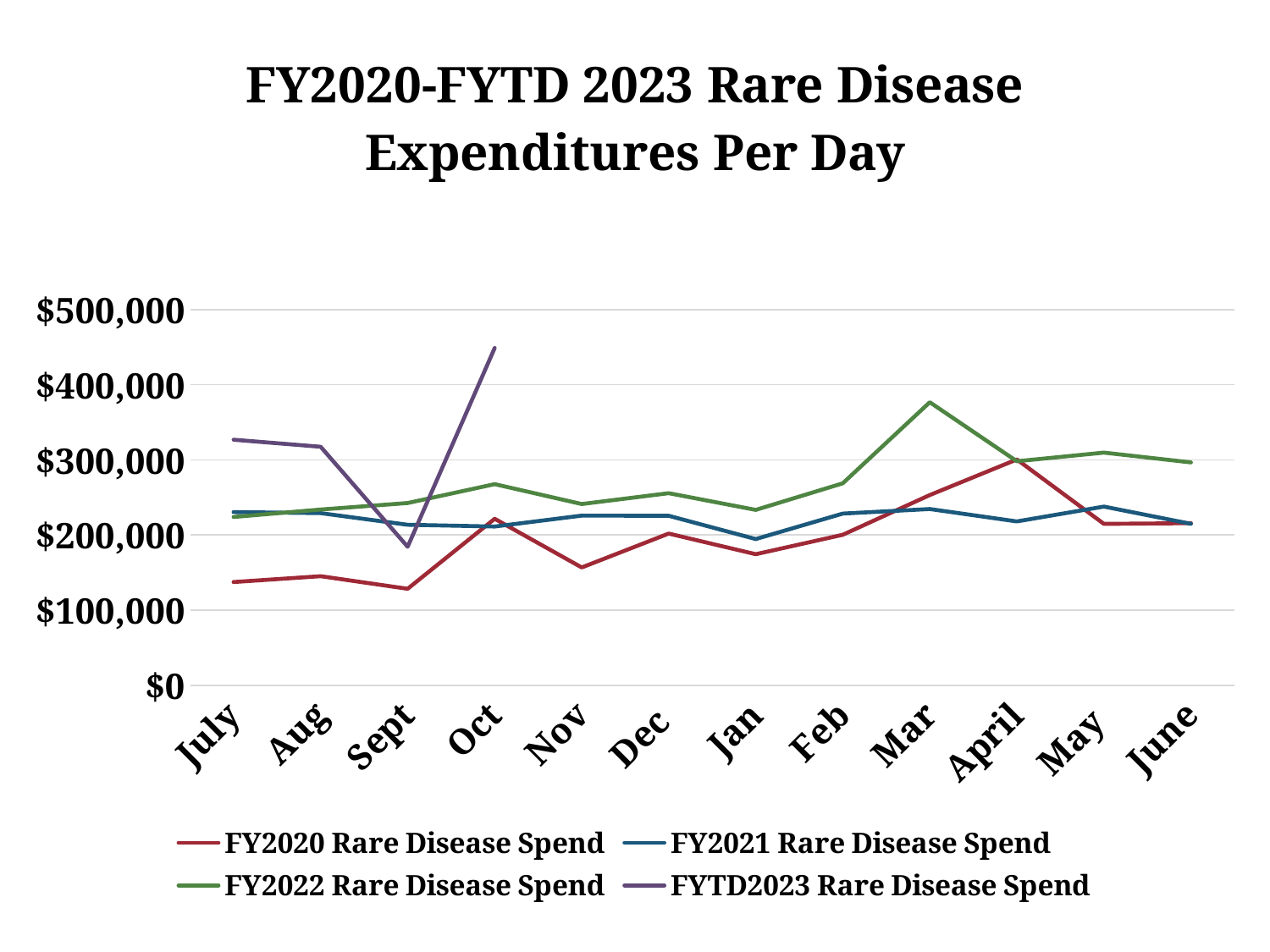
Which series has the lowest value in July? FY2020 Rare Disease Spend For how many months does the FYTD2023 Rare Disease Spend line have data points? 4 In which month does the FY2022 Rare Disease Spend line reach its highest value? Mar In which month does the FY2020 Rare Disease Spend line reach its highest value? April What kind of chart is shown on the slide? Line chart How many months are shown along the x axis? 12 How many series does the legend list? 4 Is the FYTD2023 Rare Disease Spend value for Oct greater or less than $400,000? greater In Mar, which is larger: FY2022 Rare Disease Spend or FY2020 Rare Disease Spend? FY2022 Rare Disease Spend Which series has the highest value in Oct? FYTD2023 Rare Disease Spend Is the FY2020 Rare Disease Spend value for Sept greater or less than $200,000? less Is the FY2022 Rare Disease Spend value for Mar greater or less than $300,000? greater